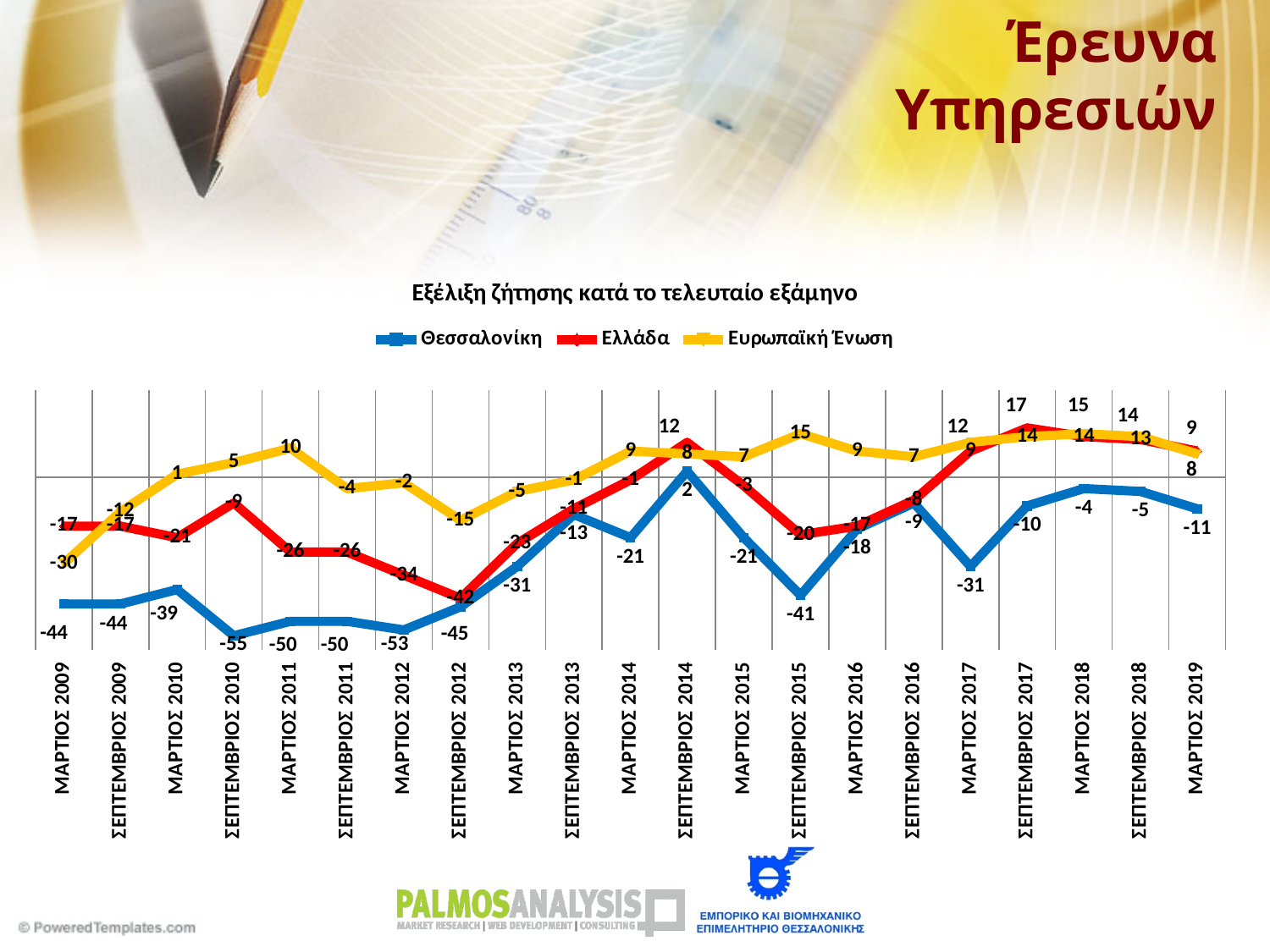
How many time points are shown on the x axis? 21 How many series does the legend list? 3 What colour is the line for Ελλάδα? red In which period does Ευρωπαϊκή Ένωση reach its highest value? ΣΕΠΤΕΜΒΡΙΟΣ 2015 and ΜΑΡΤΙΟΣ 2018 (both 15) By how much did the Θεσσαλονίκη value change from ΣΕΠΤΕΜΒΡΙΟΣ 2015 to ΜΑΡΤΙΟΣ 2016? 23 What is the value for Ελλάδα in ΣΕΠΤΕΜΒΡΙΟΣ 2012? -42 In which period does Θεσσαλονίκη reach its lowest value? ΣΕΠΤΕΜΒΡΙΟΣ 2010 What kind of chart is shown on the slide? line chart What is the value for Θεσσαλονίκη in ΣΕΠΤΕΜΒΡΙΟΣ 2010? -55 In ΜΑΡΤΙΟΣ 2017, which is higher: Ελλάδα or Θεσσαλονίκη? Ελλάδα What is the value for Ευρωπαϊκή Ένωση in ΣΕΠΤΕΜΒΡΙΟΣ 2017? 14 What is the value for Θεσσαλονίκη in ΣΕΠΤΕΜΒΡΙΟΣ 2014? 2